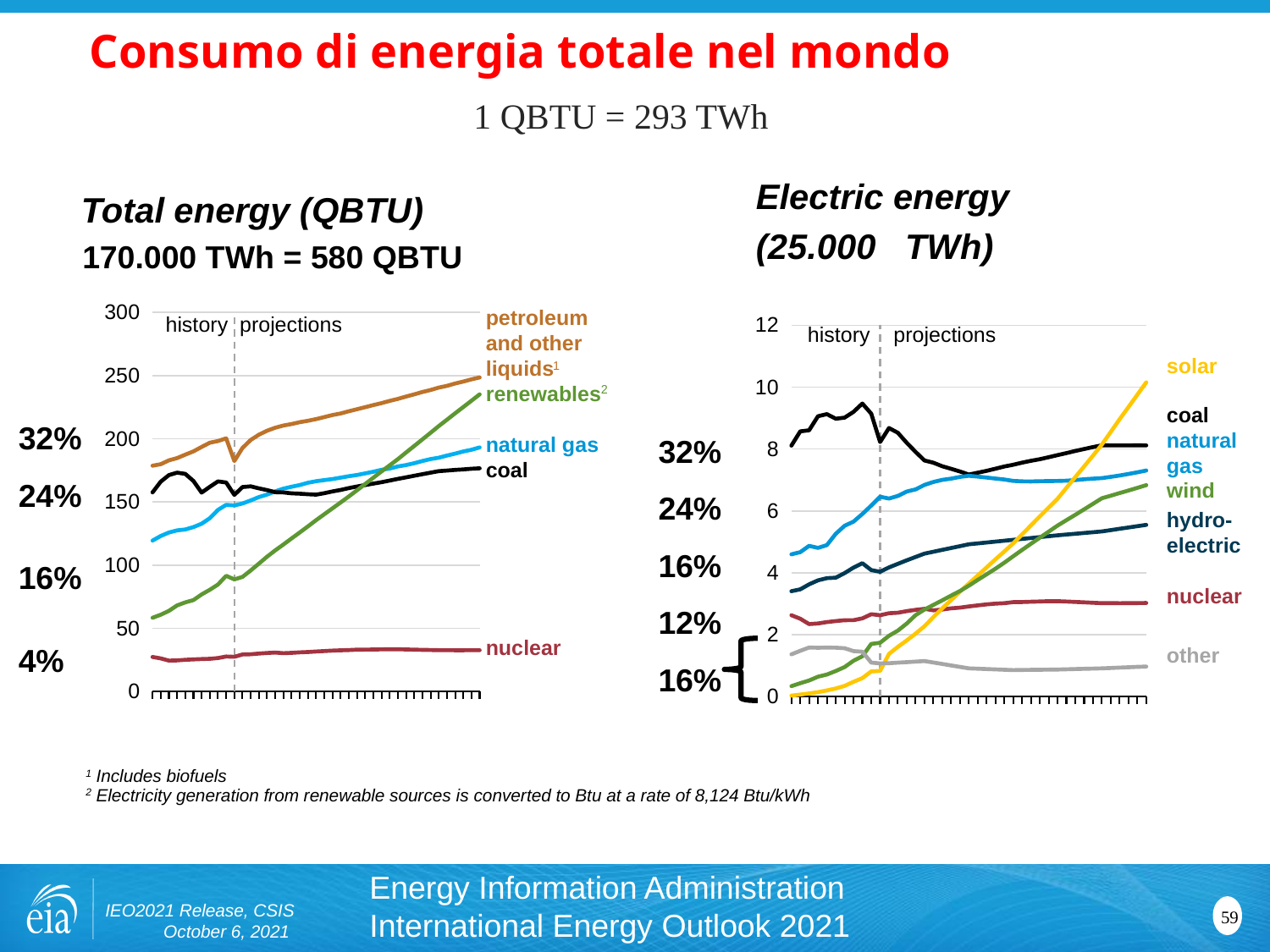
In the 'Total energy (QBTU)' chart, does the renewables series rise or fall over the projection period? rise In the 'Electric energy' chart, which series has the lowest value at the end of the projection period? other In the 'Electric energy' chart, is the value for hydroelectric at the end of the projection period greater or less than 4? greater In the 'Electric energy' chart, is the value for nuclear at the end of the projection period greater or less than 4? less In the 'Electric energy' chart, which series has the highest value at the end of the projection period? solar How many series are labelled on the 'Electric energy' chart on the right? 7 How many series are labelled on the 'Total energy (QBTU)' chart on the left? 5 In the 'Electric energy' chart, at the end of the projection period, which is larger: solar or nuclear? solar What type of chart is the 'Total energy (QBTU)' chart on the left? line chart What is the title of the chart on the right? Electric energy (25.000 TWh) In the 'Total energy (QBTU)' chart, which series has the lowest value at the end of the projection period? nuclear In the 'Total energy (QBTU)' chart, is the value for nuclear at the end of the projection period greater or less than 50? less